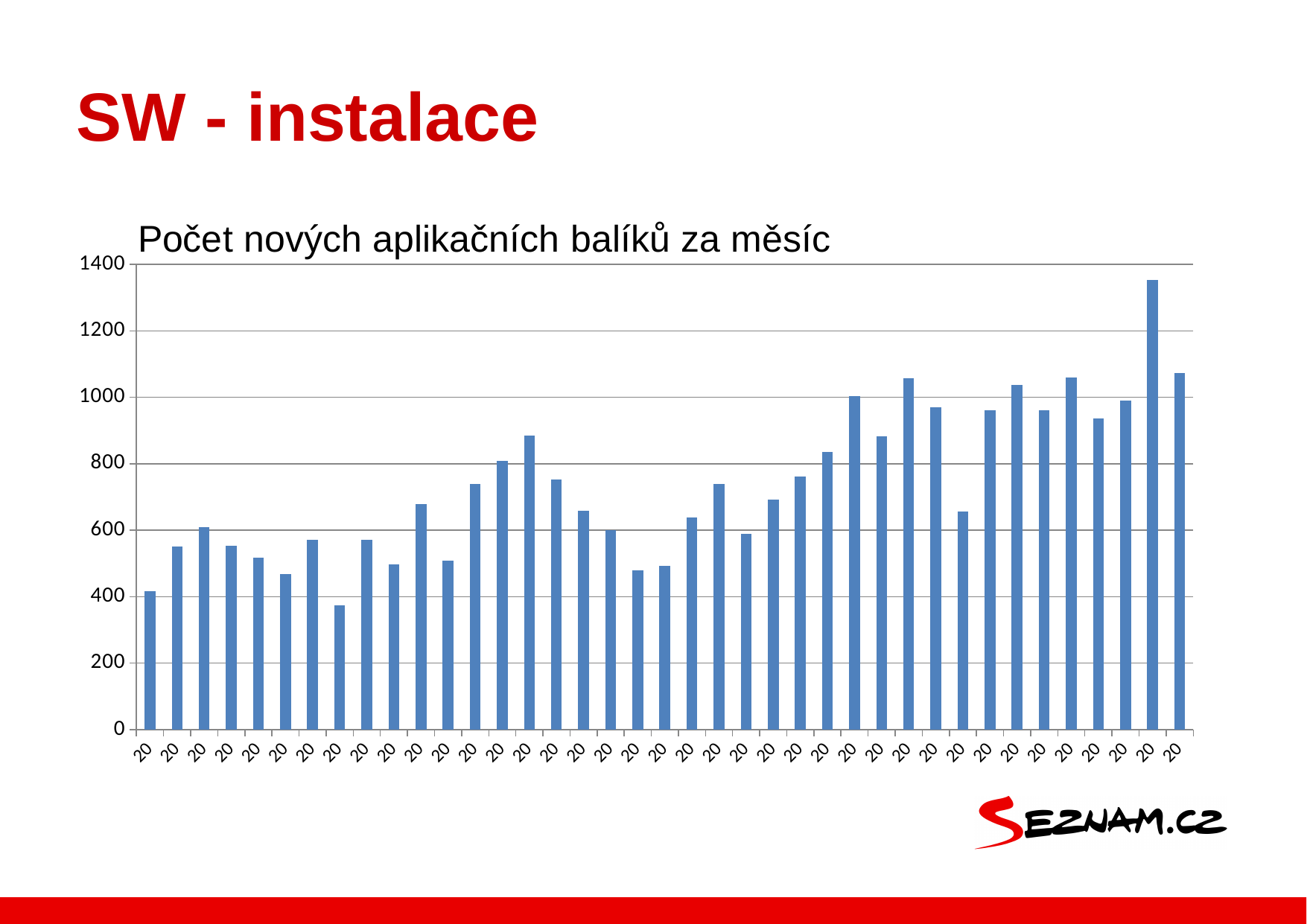
Is the value of the second bar from the left greater or less than 500? greater What kind of chart is shown on the slide? Bar chart How many bars are plotted in the chart? 39 Do the values generally rise or fall from left to right along the x axis? Rise Is the value of the rightmost bar greater or less than 1000? greater Is the value of the leftmost bar greater or less than 600? less What is the highest value shown on the y axis? 1400 Which is larger, the leftmost bar or the rightmost bar? The rightmost bar What is the title of the chart? Počet nových aplikačních balíků za měsíc